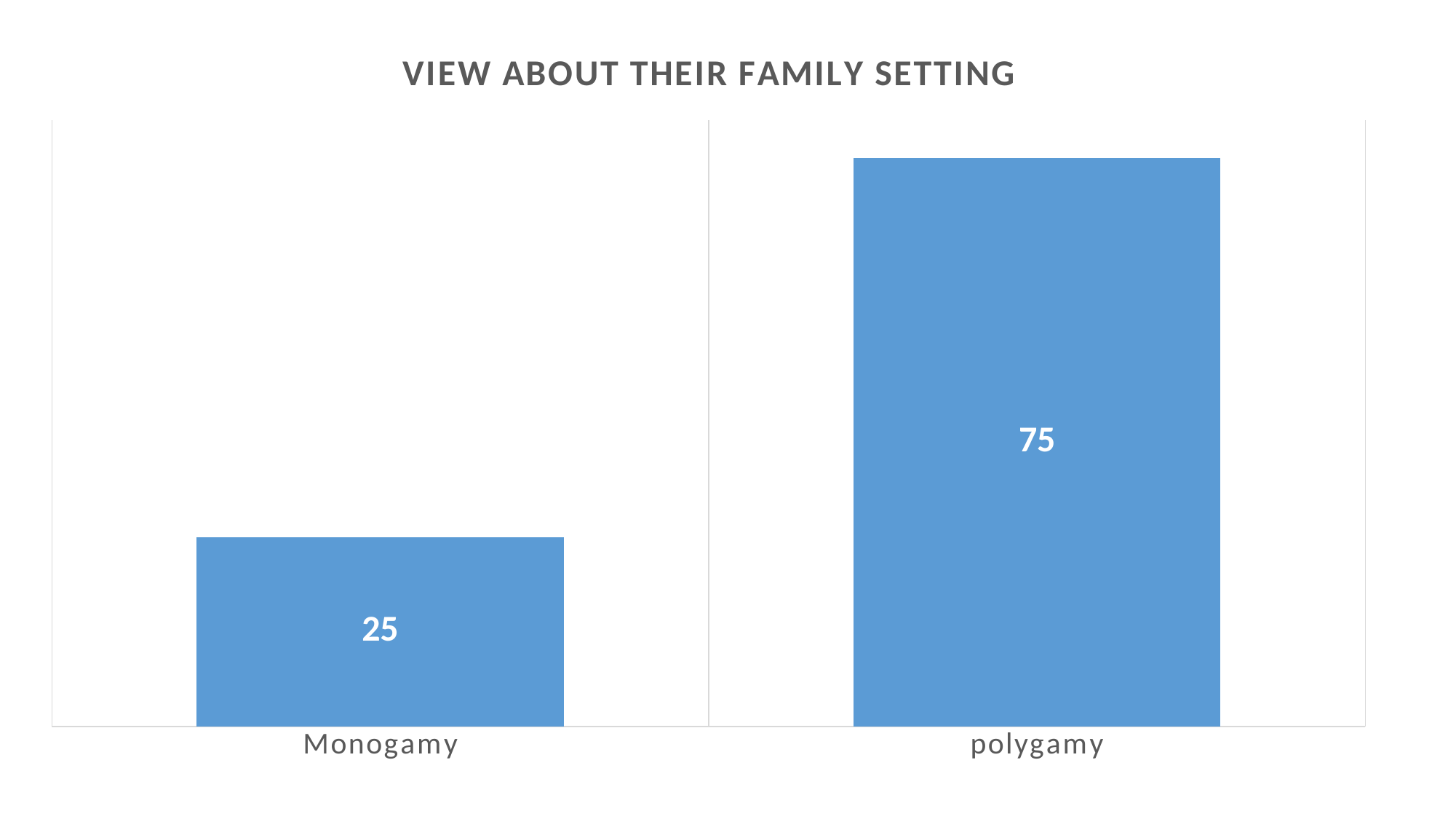
Which is larger, the value for Monogamy or the value for polygamy? polygamy What kind of chart is shown on the slide? bar chart Which category has the highest value? polygamy What colour are the bars in the chart? blue Which category has the lowest value? Monogamy What is the value for polygamy? 75 Do the values rise or fall from Monogamy to polygamy? rise How many categories are shown in the chart? 2 What is the title of the chart? VIEW ABOUT THEIR FAMILY SETTING What is the value for Monogamy? 25 What is the difference between the values for polygamy and Monogamy? 50